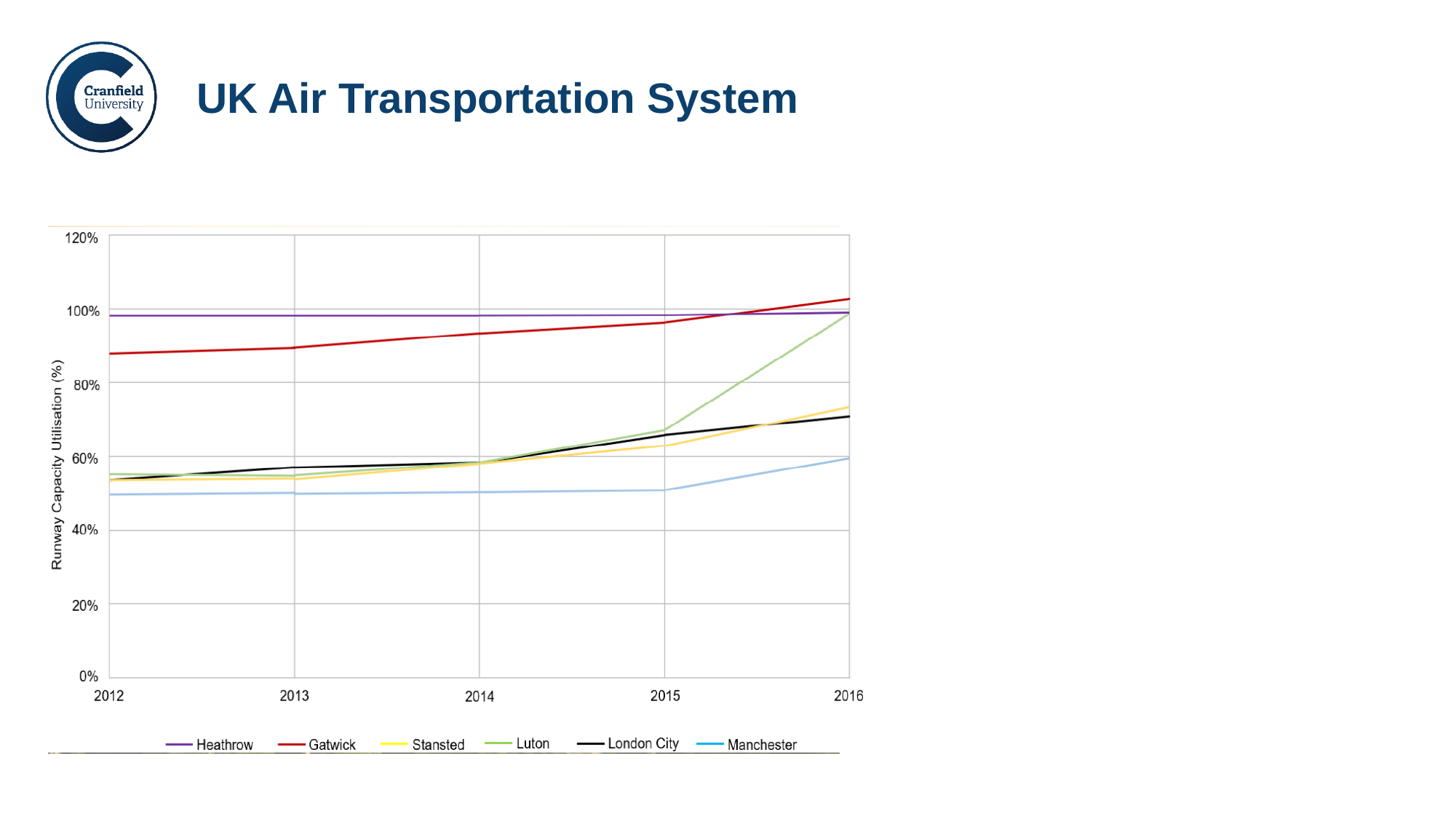
Is the value for Gatwick in 2012 greater or less than 80%? greater What is the label on the y axis? Runway Capacity Utilisation (%) Is the value for Luton in 2016 greater or less than 80%? greater Which is larger in 2014, the value for Gatwick or the value for Manchester? Gatwick Which airport has the highest runway capacity utilisation in 2012? Heathrow How many years are shown along the x axis? 5 Which airport has the lowest runway capacity utilisation in 2012? Manchester Is the value for Gatwick in 2016 greater or less than 100%? greater How many series does the legend list? 6 What kind of chart is shown on the slide? line chart Does the Gatwick line rise or fall from 2012 to 2016? rise